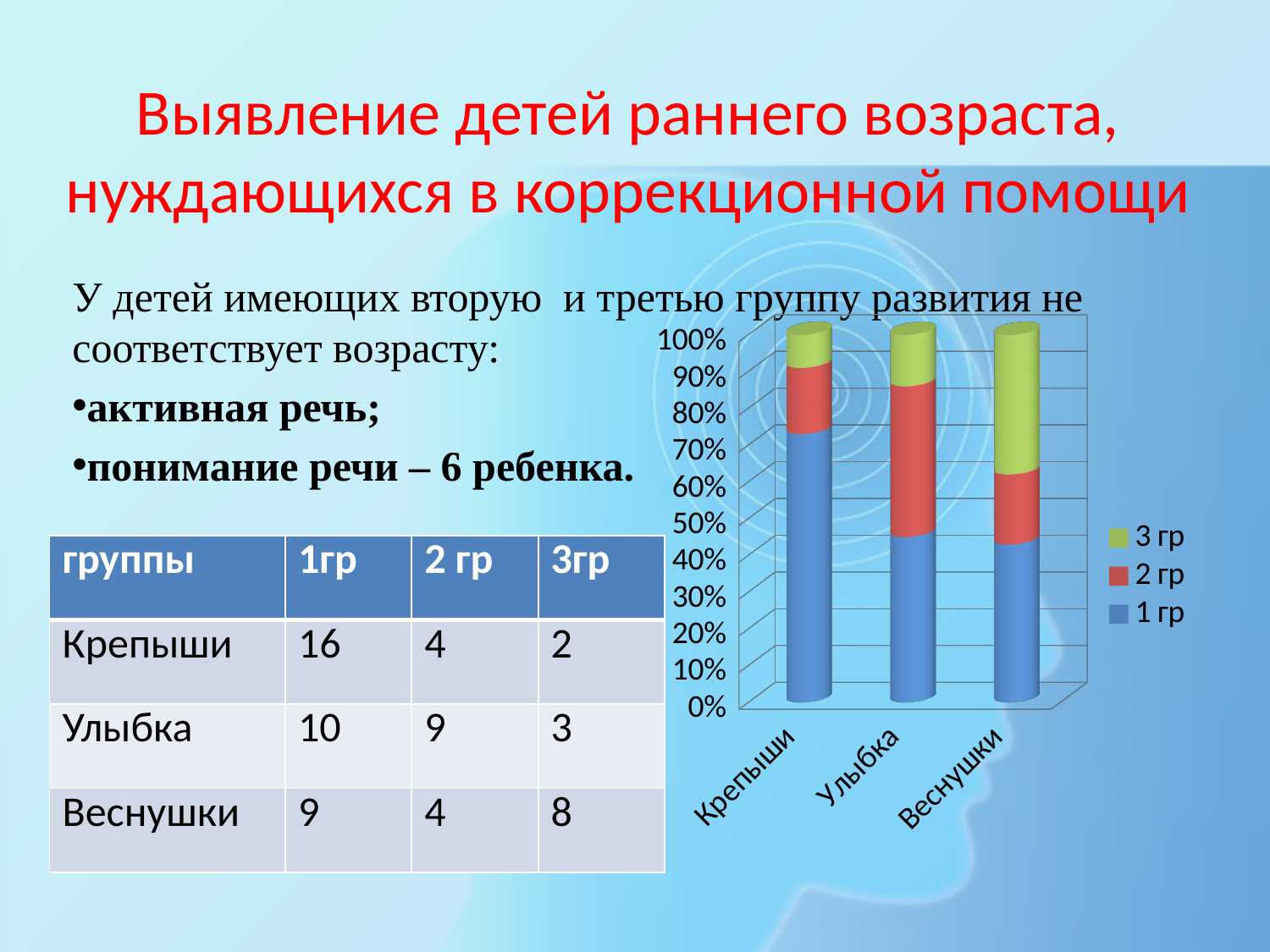
Which series is shown in green in the chart? 3 гр What are the entries in the chart legend? 3 гр, 2 гр, 1 гр Which category has the larger share for 2 гр: Улыбка or Крепыши? Улыбка Which category has the largest share for 3 гр in the chart? Веснушки What kind of chart is shown on the slide? stacked bar chart Is the share for 1 гр in Крепыши greater or less than 60%? greater Which category has the smallest share for 3 гр in the chart? Крепыши How many series does the chart legend list? 3 Is the share for 1 гр in Улыбка greater or less than 50%? less Does the share for 1 гр rise or fall from Крепыши to Веснушки along the x axis? fall How many categories are shown on the x axis of the chart? 3 Which category has the largest share for 1 гр in the chart? Крепыши